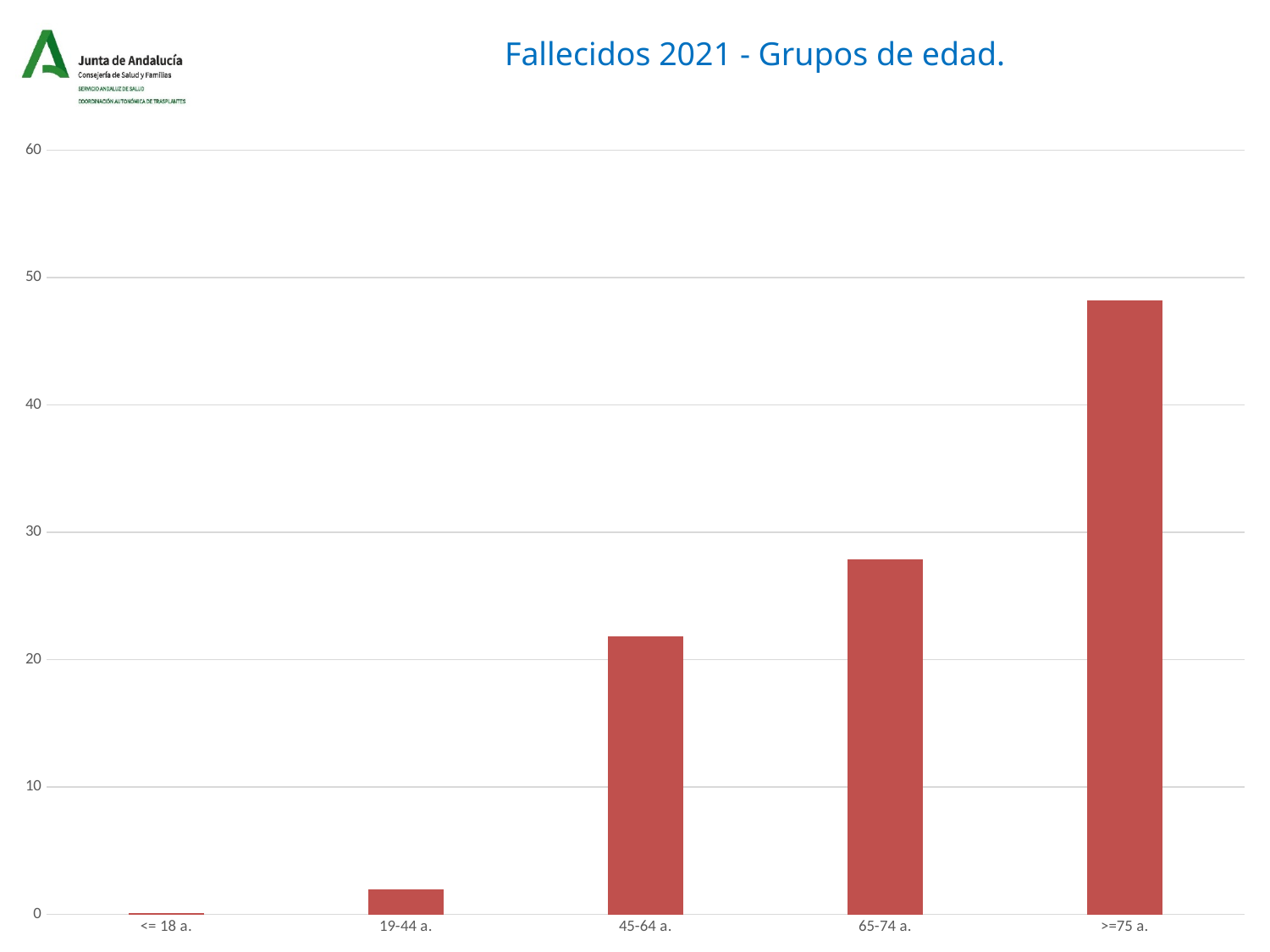
Is the value for 45-64 a. greater or less than 20? greater Is the value for >=75 a. greater or less than 50? less Which age group has the lowest value? <= 18 a. Is the value for 19-44 a. greater or less than 10? less Which age group has the highest value? >=75 a. What kind of chart is shown on the slide? bar chart Do the values rise or fall as the age groups move from left to right along the x axis? rise How many age-group categories are shown on the x axis? 5 What is the title of the chart? Fallecidos 2021 - Grupos de edad. Which is larger, the value for 65-74 a. or the value for 45-64 a.? 65-74 a.